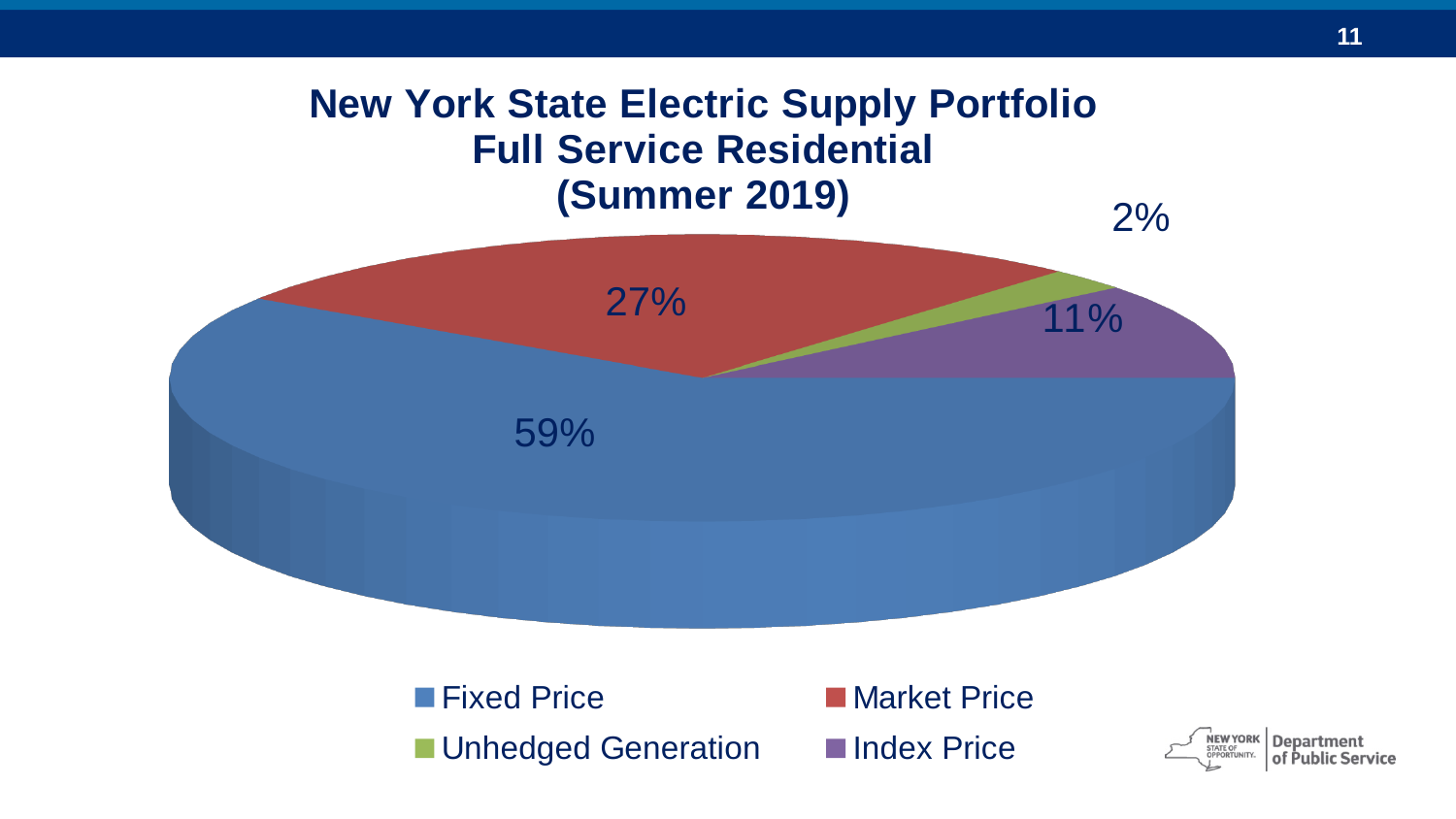
How many categories does the pie chart show? 4 What share of the pie does Market Price represent? 27% Which is larger, the Index Price slice or the Market Price slice? Market Price What kind of chart is shown on the slide? Pie chart What colour is the Index Price slice in the pie chart? Purple What share of the pie does Fixed Price represent? 59% Which category has the largest slice of the pie? Fixed Price Which category has the smallest slice of the pie? Unhedged Generation What is the difference in percentage points between Fixed Price and Market Price? 32 What share of the pie does Unhedged Generation represent? 2% What is the difference in percentage points between Market Price and Index Price? 16